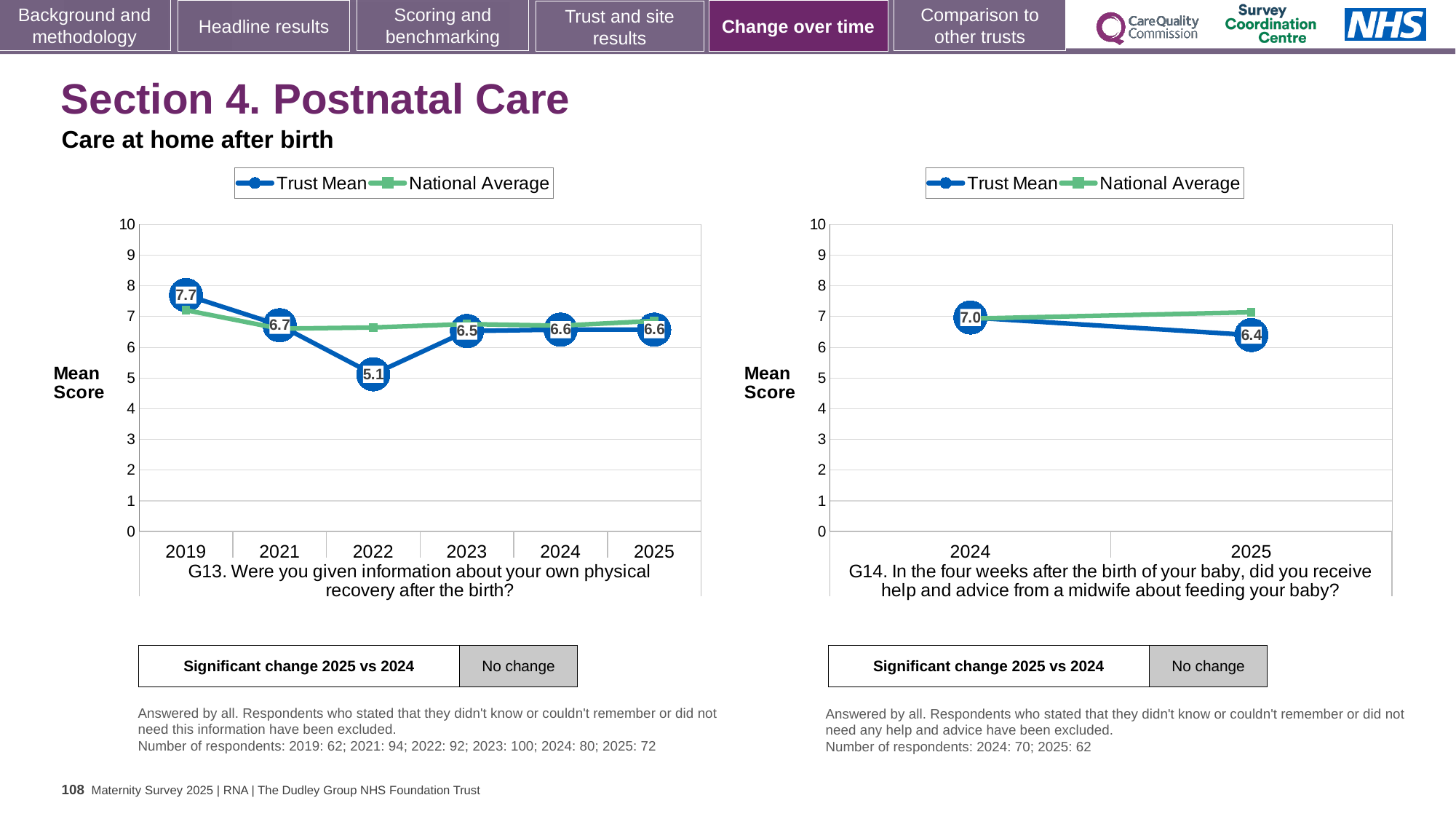
On the G13 chart (left), what is the difference between the Trust Mean scores for 2019 and 2022? 2.6 On the G14 chart (right), does the Trust Mean rise or fall from 2024 to 2025? fall On the G13 chart (left), what is the Trust Mean score for 2022? 5.1 On the G13 chart (left), what is the Trust Mean score for 2019? 7.7 On the G13 chart (left), is the National Average for 2022 greater or less than 6? greater On the G13 chart (left), which year has the lowest Trust Mean score? 2022 On the G14 chart (right), how many series does the legend list? 2 On the G14 chart (right), what is the difference between the Trust Mean scores for 2024 and 2025? 0.6 What kind of chart is the G13 chart on the left? line chart On the G13 chart (left), which year has the highest Trust Mean score? 2019 On the G13 chart (left), how many years are plotted on the x axis? 6 On the G14 chart (right), what is the Trust Mean score for 2025? 6.4